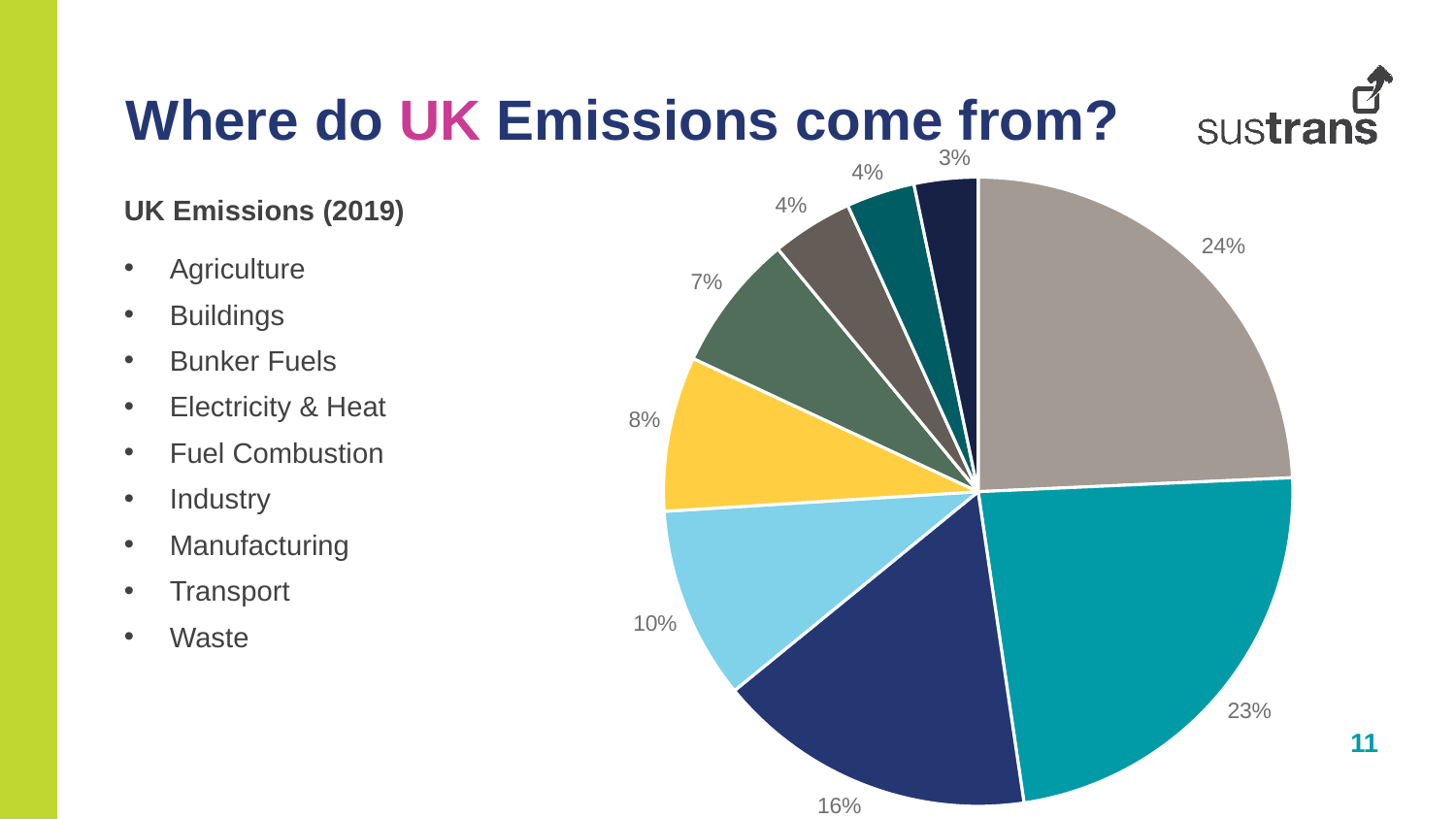
What year do the UK emissions shown on the slide refer to? 2019 How many slices does the pie chart have? 9 What percentage is shown on the yellow slice of the pie chart? 8% What is the percentage shown on the smallest slice of the pie chart? 3% What kind of chart is shown on the slide? pie chart What is the difference between the two largest slices of the pie chart (24% and 23%)? 1 percentage point What is the percentage shown on the largest slice of the pie chart? 24% What is the difference between the slice labelled 16% and the slice labelled 10%? 6 percentage points How many slices of the pie chart are labelled 4%? 2 What percentage is shown on the dark green slice of the pie chart? 7% What do the two largest slices of the pie chart (24% and 23%) add up to? 47% Which is larger, the dark blue slice or the light blue slice of the pie chart? dark blue